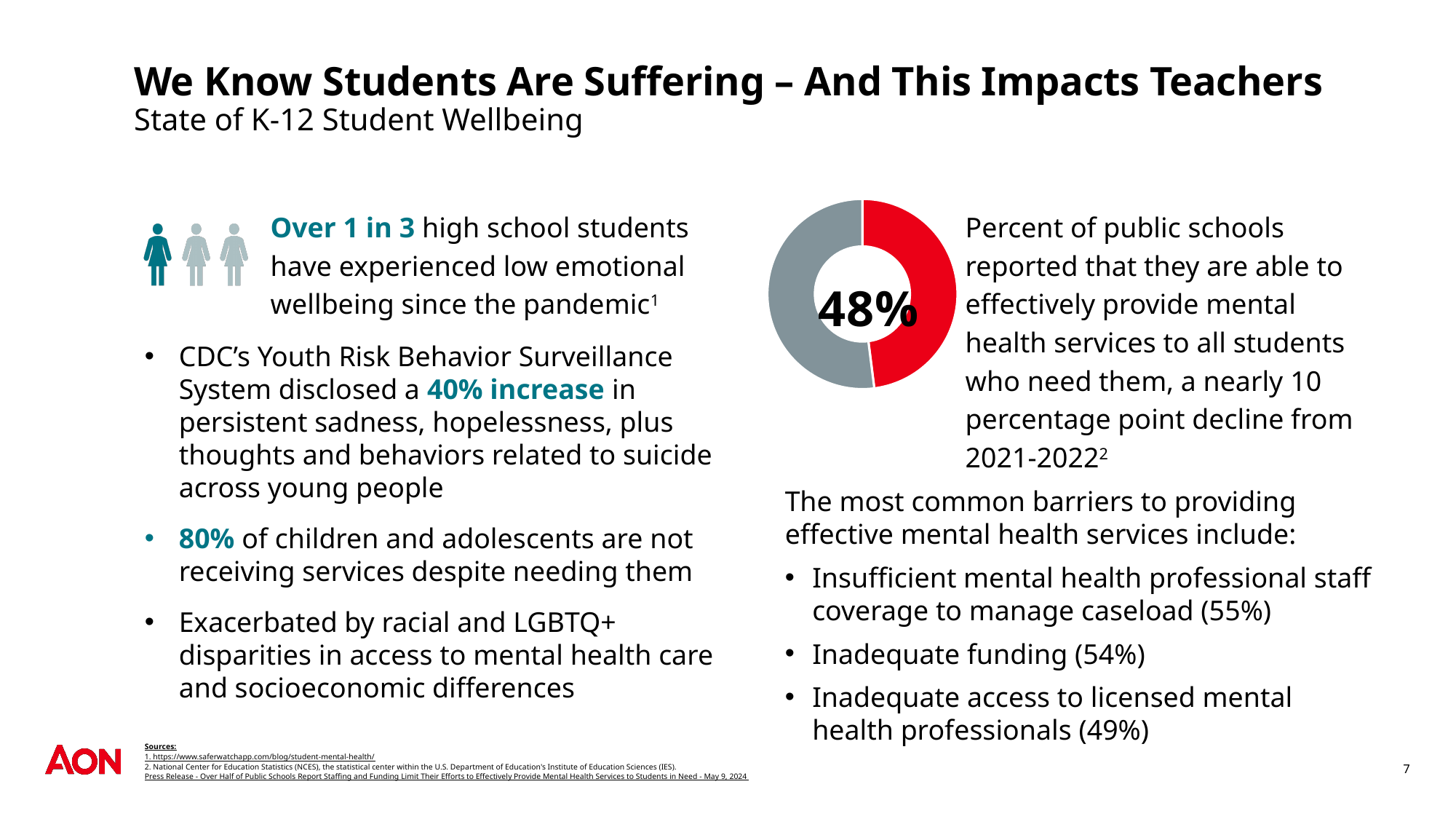
According to the text next to the donut chart, what does the 48% represent? Percent of public schools reported that they are able to effectively provide mental health services to all students who need them How many segments does the donut chart have? 2 What value is printed in the centre of the donut chart? 48% Which segment of the donut chart is larger, the red one or the gray one? the gray one What colour is the segment of the donut chart labelled 48%? red What kind of chart is shown on the right side of the slide? donut chart What share of the donut chart does the red segment represent? 48% Is the red segment of the donut chart greater or less than 50%? less